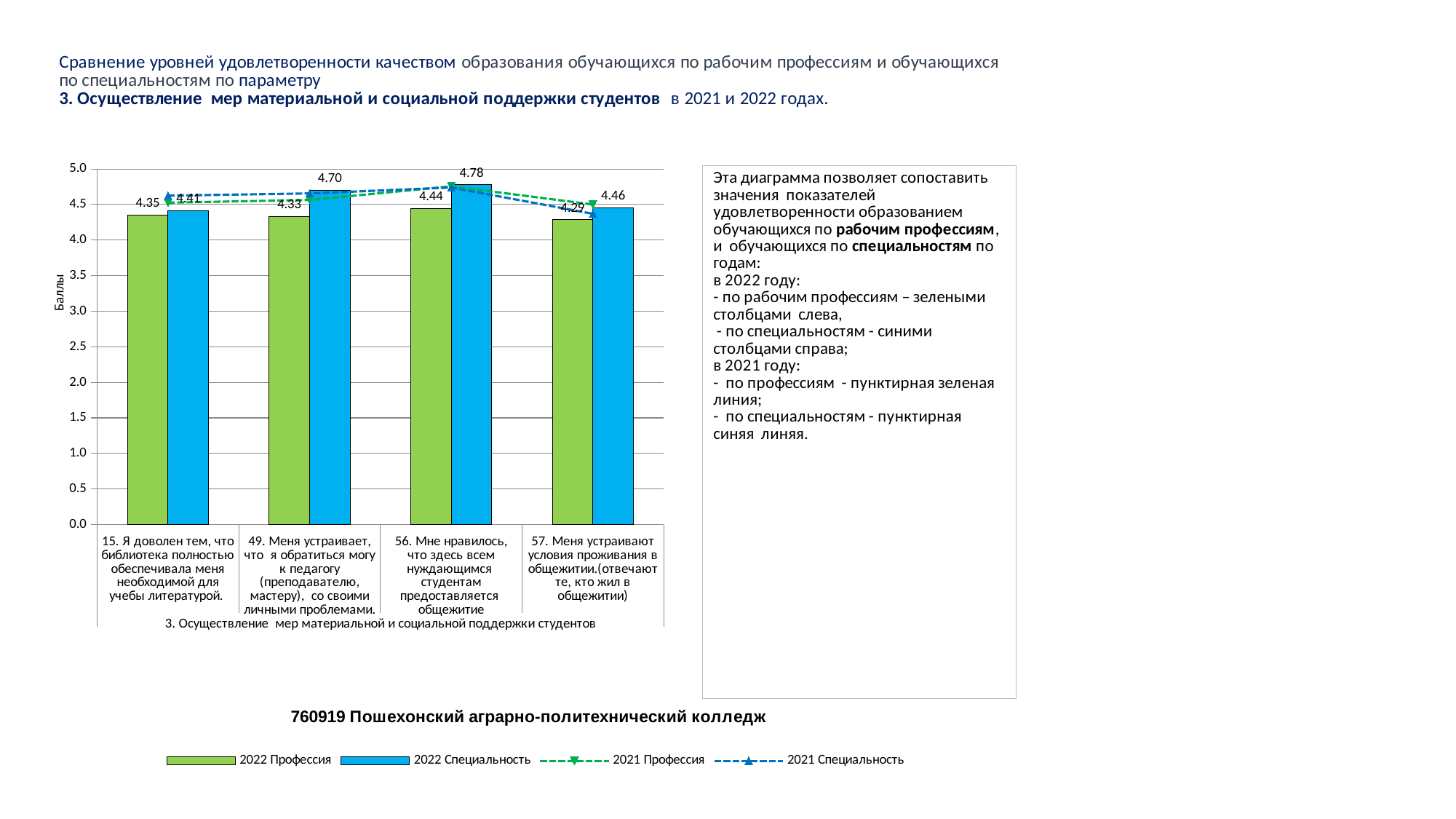
What is the label of the vertical axis? Баллы What type of chart is used for the 2022 data series? Bar chart What is the difference between the 2022 Специальность and 2022 Профессия bars for item 49? 0.37 What is the value of the 2022 Специальность bar for item 56 (Мне нравилось, что здесь всем нуждающимся студентам предоставляется общежитие)? 4.78 How many categories (survey items) are shown on the x axis? 4 What is the value of the 2022 Профессия bar for item 15 (Я доволен тем, что библиотека полностью обеспечивала меня необходимой для учебы литературой)? 4.35 Which category has the lowest 2022 Профессия bar? 57. Меня устраивают условия проживания в общежитии What is the value of the 2022 Специальность bar for item 49 (Меня устраивает, что я обратиться могу к педагогу)? 4.70 For item 56, which is larger: the 2022 Профессия bar or the 2022 Специальность bar? 2022 Специальность What is the value of the 2022 Профессия bar for item 57 (Меня устраивают условия проживания в общежитии)? 4.29 Which category has the highest 2022 Специальность bar? 56. Мне нравилось, что здесь всем нуждающимся студентам предоставляется общежитие How many series does the legend list? 4